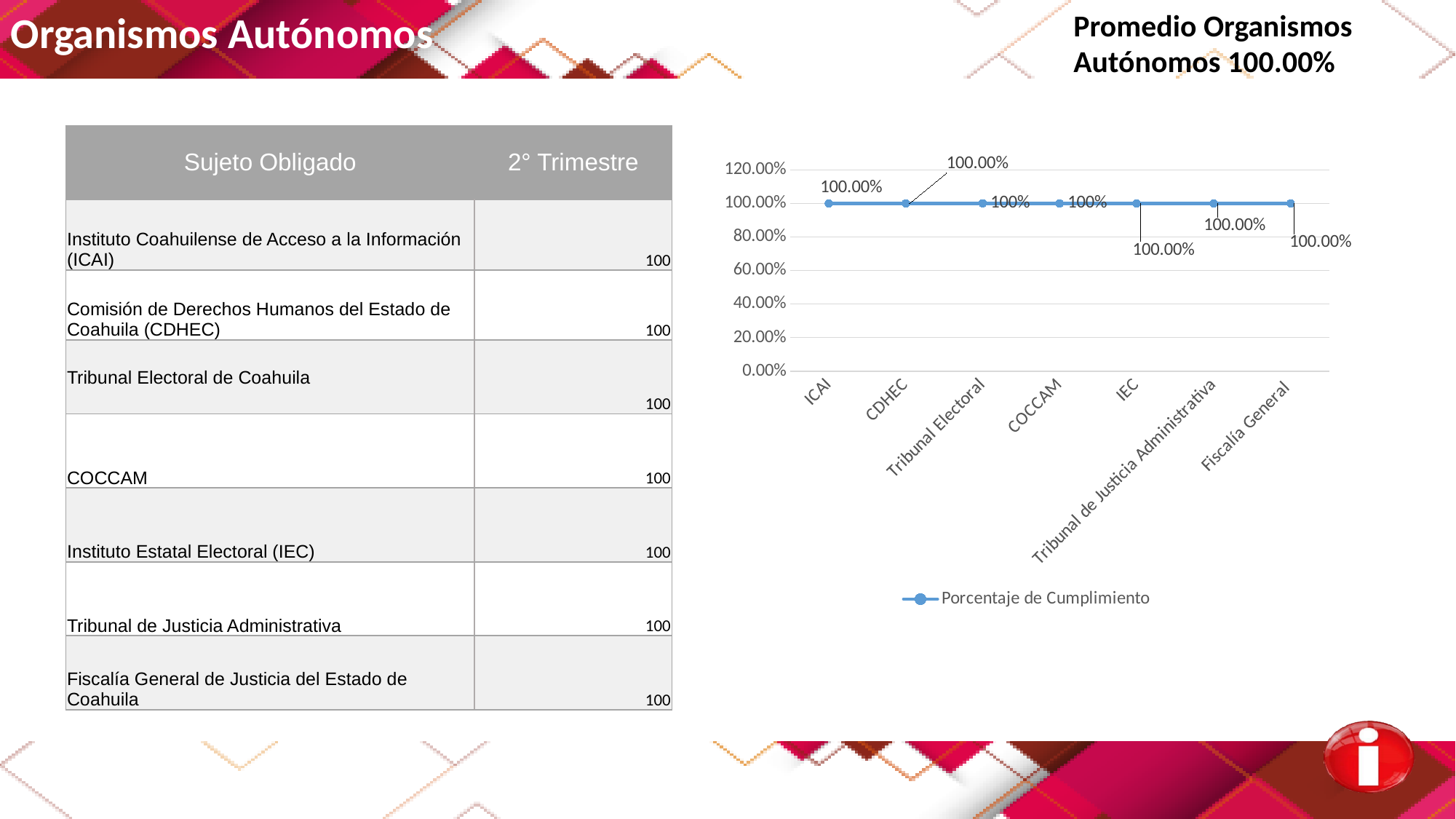
What is the name of the series shown in the chart legend? Porcentaje de Cumplimiento Do the values rise, fall, or stay flat across the categories on the x axis? stay flat What is the value for Fiscalía General in the chart? 100.00% What is the value for ICAI in the chart? 100.00% What type of chart is shown on the slide? line chart What is the value for CDHEC in the chart? 100.00% What is the value labelled for Tribunal Electoral in the chart? 100% What is the value labelled for COCCAM in the chart? 100% Is the value for Tribunal de Justicia Administrativa greater or less than 80.00%? greater How many categories are plotted along the x axis of the chart? 7 How many series does the chart legend list? 1 What is the value for IEC in the chart? 100.00%